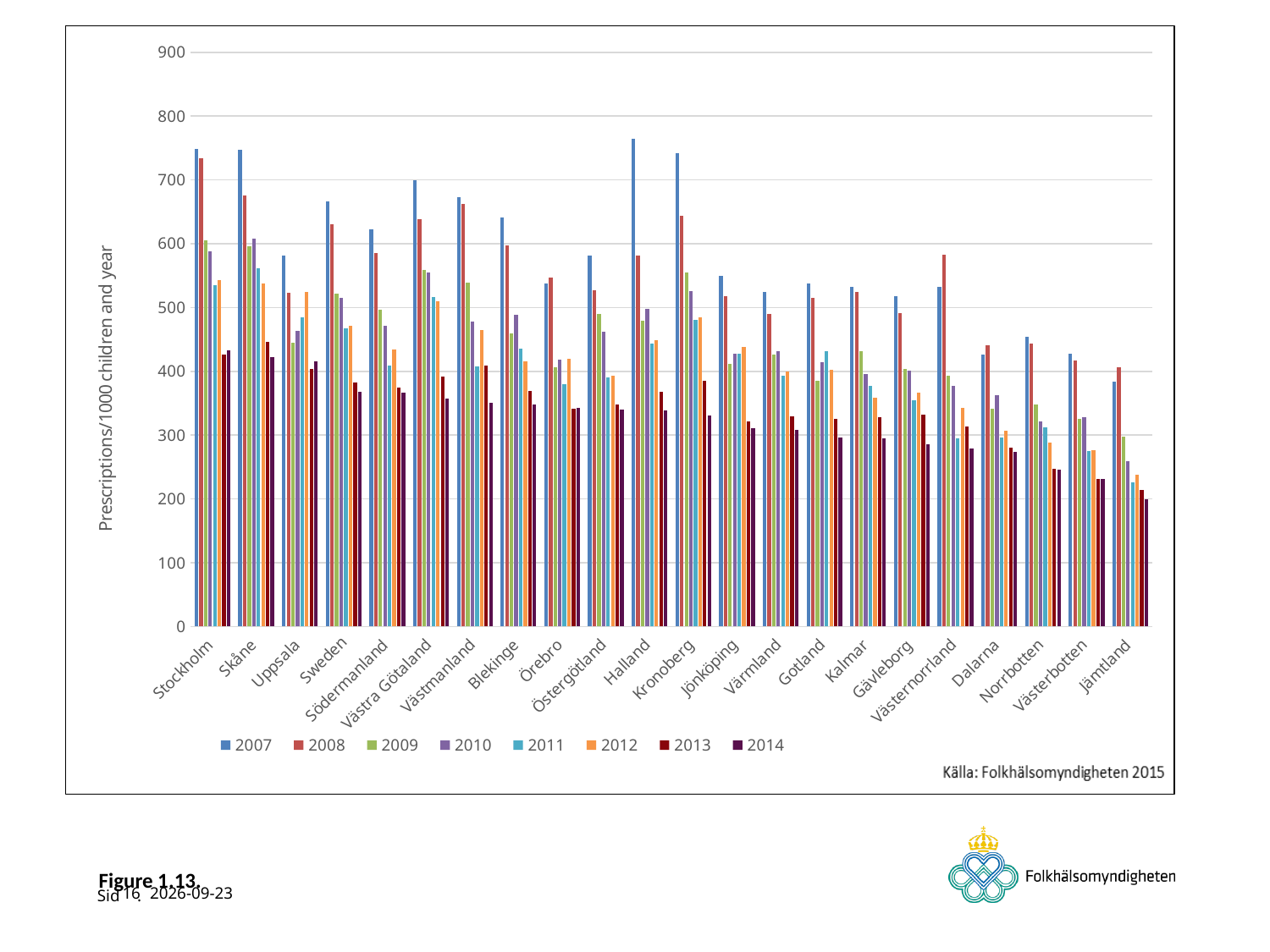
What is the label on the y axis? Prescriptions/1000 children and year How many regions (categories) are shown along the x axis? 22 Is the 2007 value for Stockholm greater or less than 700? greater How many series does the legend list? 8 What kind of chart is shown on the slide? bar chart For Stockholm, do the values generally rise or fall from 2007 to 2014? fall Which region has the lowest 2007 value? Jämtland Is the 2008 value for Västernorrland greater or less than 500? greater Is the 2014 value for Jämtland greater or less than 250? less Which is larger, the 2007 value for Stockholm or the 2007 value for Jämtland? Stockholm For Västernorrland, which is larger, the 2007 value or the 2008 value? 2008